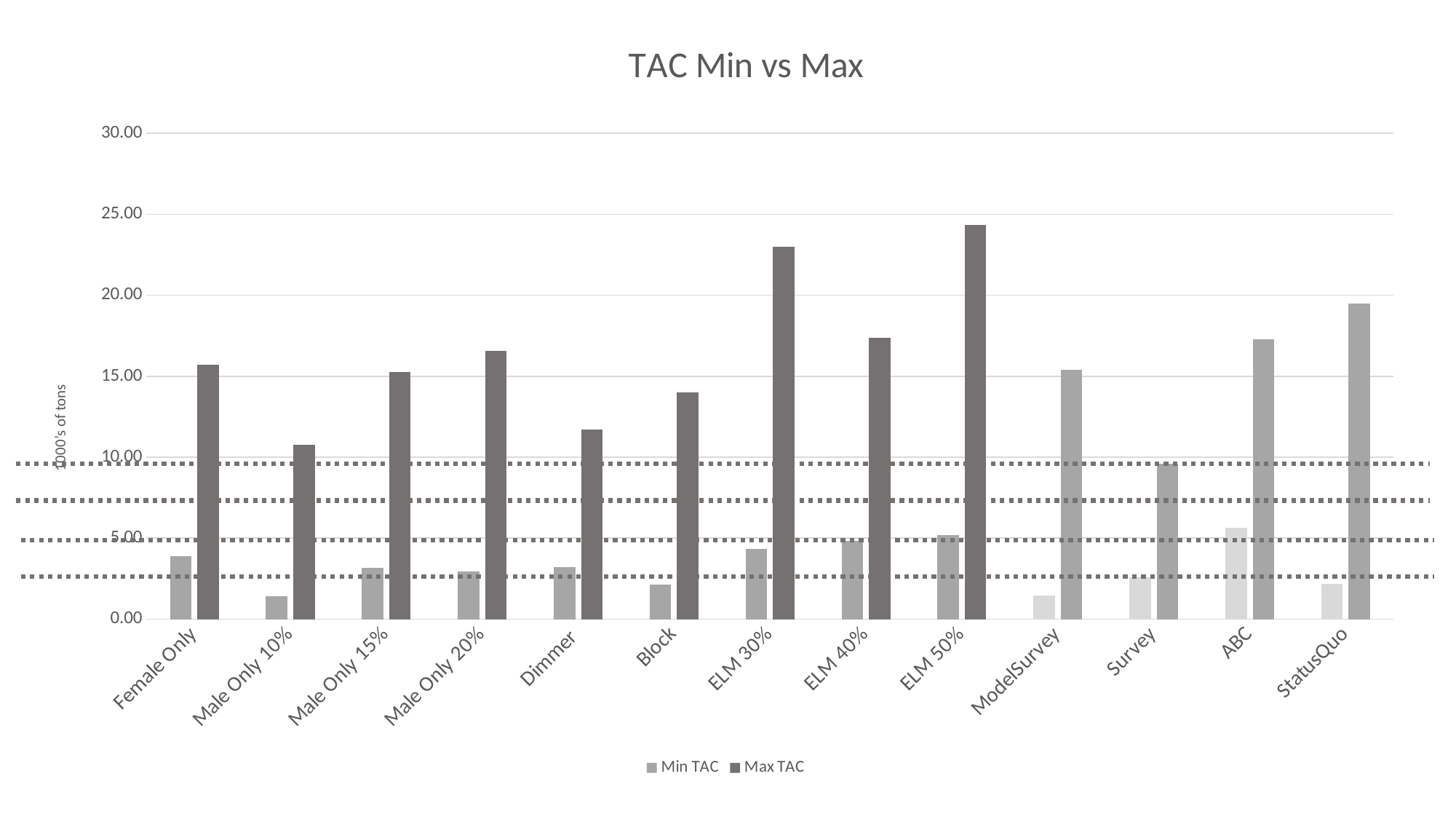
Is the Max TAC value for Survey greater or less than 15.00? less Which has the larger Max TAC value, ELM 40% or Block? ELM 40% Is the Max TAC value for ELM 30% greater or less than 20.00? greater How many series does the legend list? 2 Is the Max TAC value for StatusQuo greater or less than 15.00? greater What is the title of the chart? TAC Min vs Max How many categories are shown on the x axis? 13 What kind of chart is shown on the slide? bar chart Which category has the highest Max TAC value? ELM 50% Which has the larger Min TAC value, Female Only or Male Only 10%? Female Only